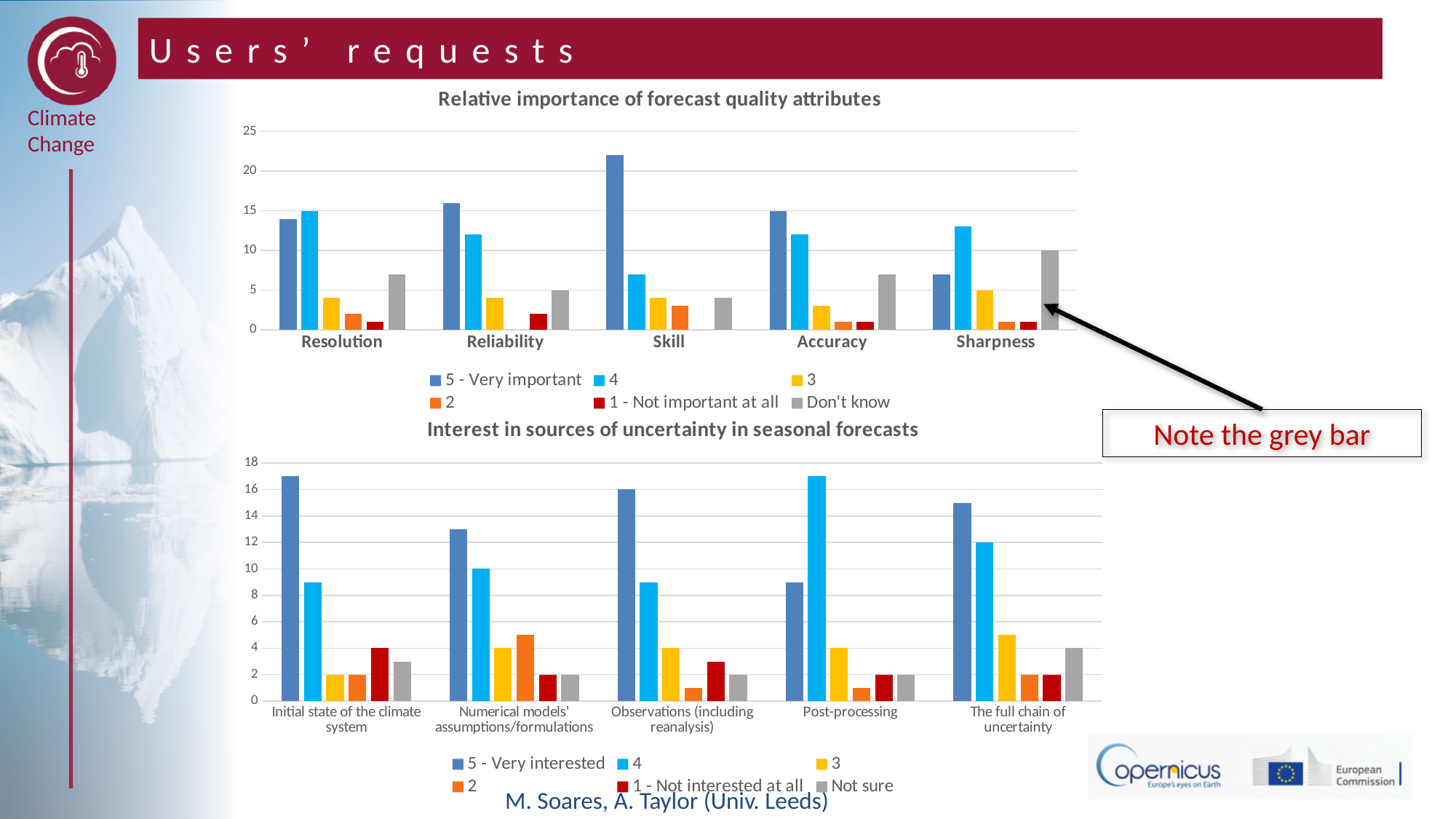
In the 'Relative importance of forecast quality attributes' chart, how many attributes are shown on the x axis? 5 In the 'Relative importance of forecast quality attributes' chart, how many series does the legend list? 6 In the 'Relative importance of forecast quality attributes' chart, is the '5 - Very important' value for Skill greater or less than 20? greater In the 'Relative importance of forecast quality attributes' chart, which attribute has the tallest 'Don't know' bar? Sharpness In the 'Interest in sources of uncertainty in seasonal forecasts' chart, what is the '5 - Very interested' value for 'Observations (including reanalysis)'? 16 In the 'Interest in sources of uncertainty in seasonal forecasts' chart, is the '5 - Very interested' value for 'Initial state of the climate system' greater or less than 16? greater In the 'Interest in sources of uncertainty in seasonal forecasts' chart, which source has the highest '4' bar? Post-processing In the 'Interest in sources of uncertainty in seasonal forecasts' chart, which is larger for Post-processing: the '5 - Very interested' bar or the '4' bar? 4 In the 'Relative importance of forecast quality attributes' chart, which attribute has the highest '5 - Very important' bar? Skill What type of chart is used for 'Interest in sources of uncertainty in seasonal forecasts'? Bar chart In the 'Interest in sources of uncertainty in seasonal forecasts' chart, what is the '4' value for 'The full chain of uncertainty'? 12 In the 'Relative importance of forecast quality attributes' chart, what is the 'Don't know' value for Sharpness? 10